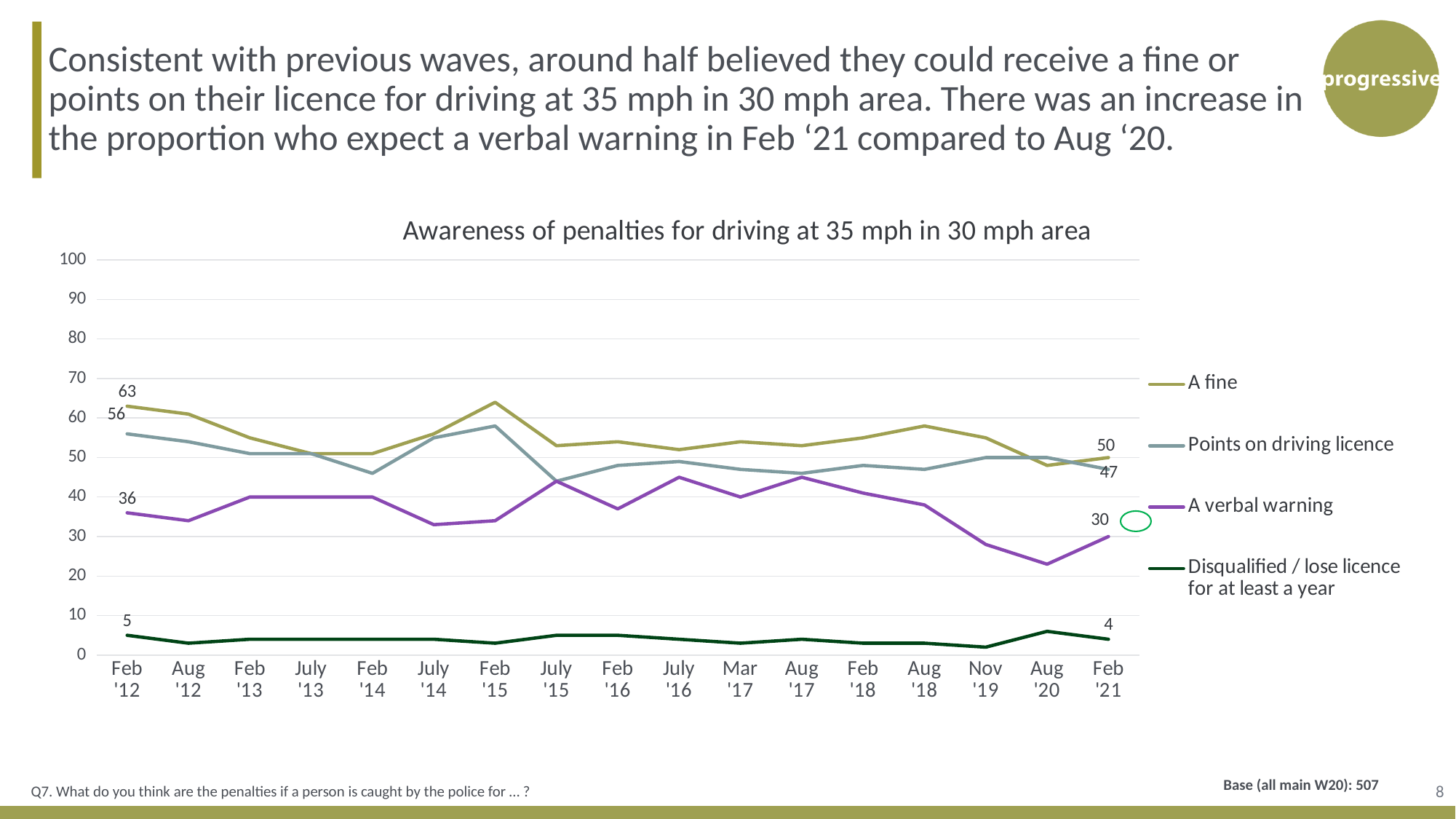
What is the value for 'Points on driving licence' in Feb '21? 47 What is the title of the chart? Awareness of penalties for driving at 35 mph in 30 mph area Is the value for 'A verbal warning' in Aug '20 greater or less than 30? less Which is larger in Feb '12: the value for 'A fine' or the value for 'Points on driving licence'? A fine What is the value for 'A verbal warning' in Feb '21? 30 Which series has the lowest value in Feb '21? Disqualified / lose licence for at least a year How many series does the legend list? 4 What is the value for 'A fine' in Feb '12? 63 What is the difference between the 'A fine' values in Feb '12 and Feb '21? 13 What kind of chart is shown on the slide? line chart How many time points are shown on the x axis? 17 What is the value for 'Disqualified / lose licence for at least a year' in Feb '12? 5